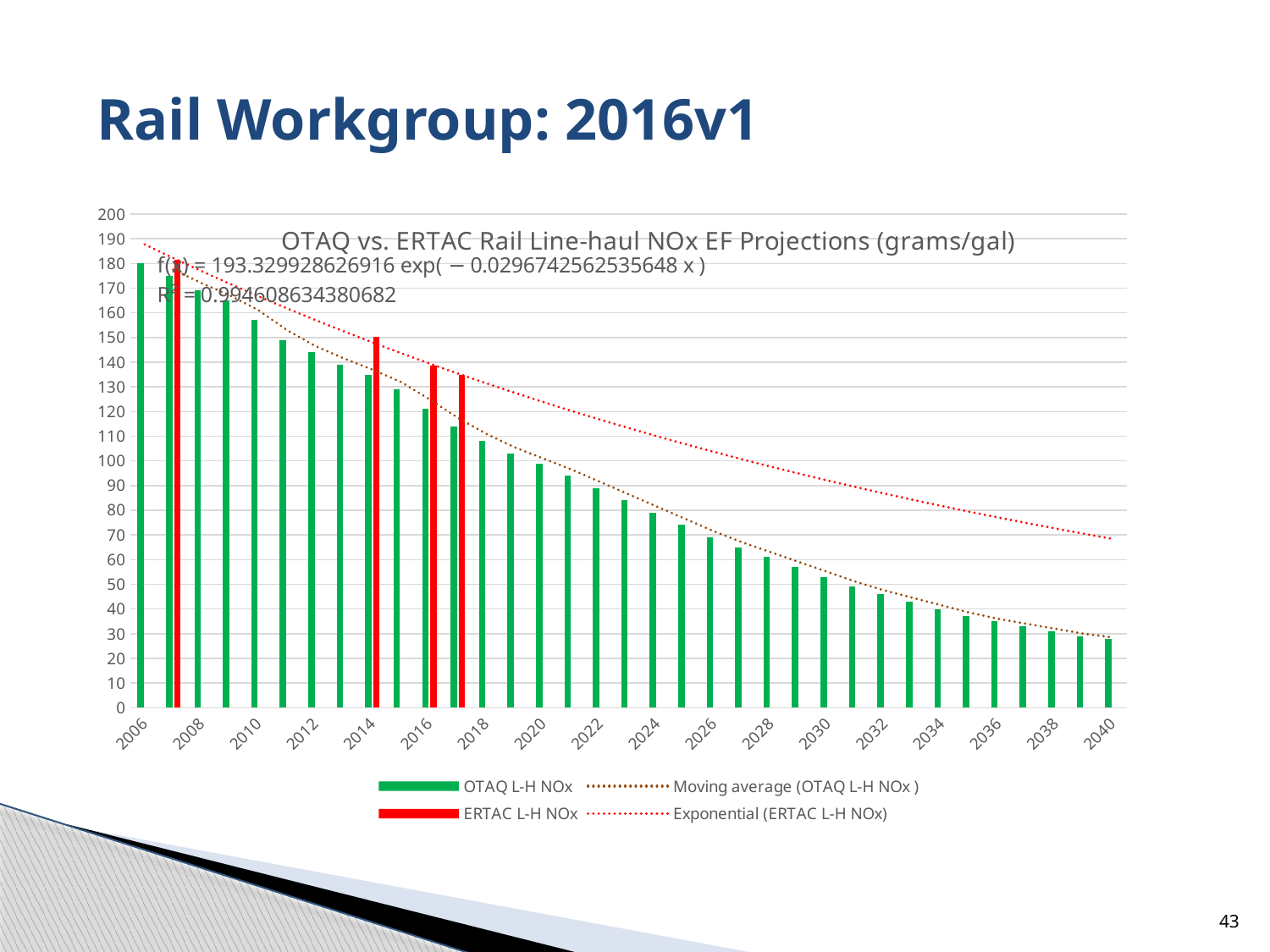
What kind of chart is shown on the slide? bar chart In which year is the OTAQ L-H NOx value lowest? 2040 What is the title of the chart? OTAQ vs. ERTAC Rail Line-haul NOx EF Projections (grams/gal) How many entries does the chart legend list? 4 In 2014, which is larger: the ERTAC L-H NOx value or the OTAQ L-H NOx value? ERTAC L-H NOx Is the OTAQ L-H NOx value for 2040 greater or less than 30? less Is the OTAQ L-H NOx value for 2032 greater or less than 50? less In which year is the OTAQ L-H NOx value highest? 2006 Is the OTAQ L-H NOx value for 2010 greater or less than 150? greater Do the OTAQ L-H NOx values rise or fall from 2006 to 2040? fall How many red ERTAC L-H NOx bars are plotted on the chart? 4